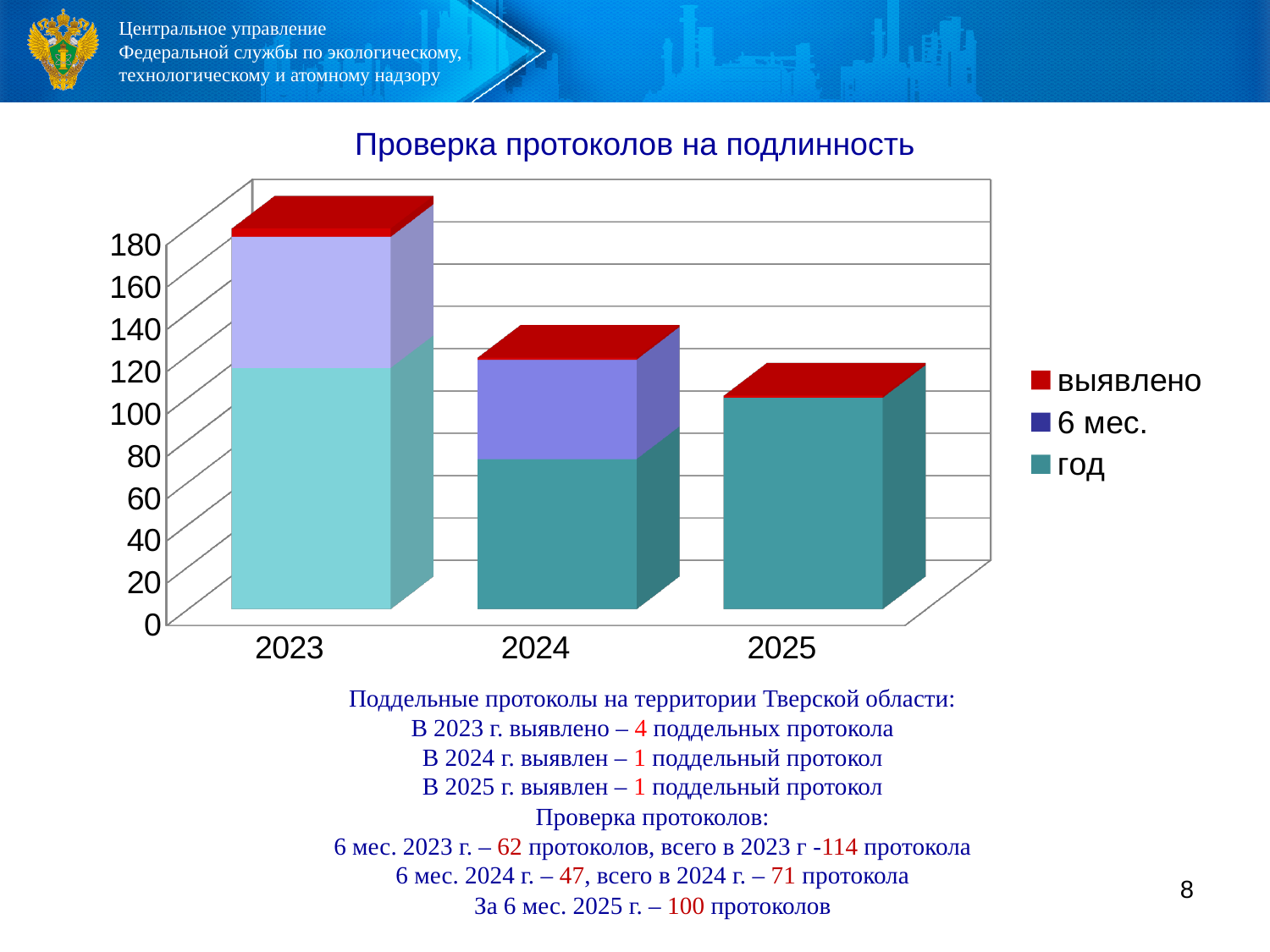
What kind of chart is shown on the slide? bar chart Which year has the shortest stacked bar? 2025 What is the title of the chart? Проверка протоколов на подлинность Is the total height of the 2025 bar greater or less than 140? less What are the entries in the chart legend? выявлено, 6 мес., год Which year has the tallest stacked bar? 2023 How many years are shown on the x axis of the chart? 3 According to the slide, how many protocols were checked in the first 6 months of 2023 (the '6 мес.' value for 2023)? 62 Do the total heights of the stacked bars rise or fall from 2023 to 2025? fall Is the total height of the 2023 bar greater or less than 140? greater How many series does the chart legend list? 3 Which stacked bar is taller, 2023 or 2025? 2023